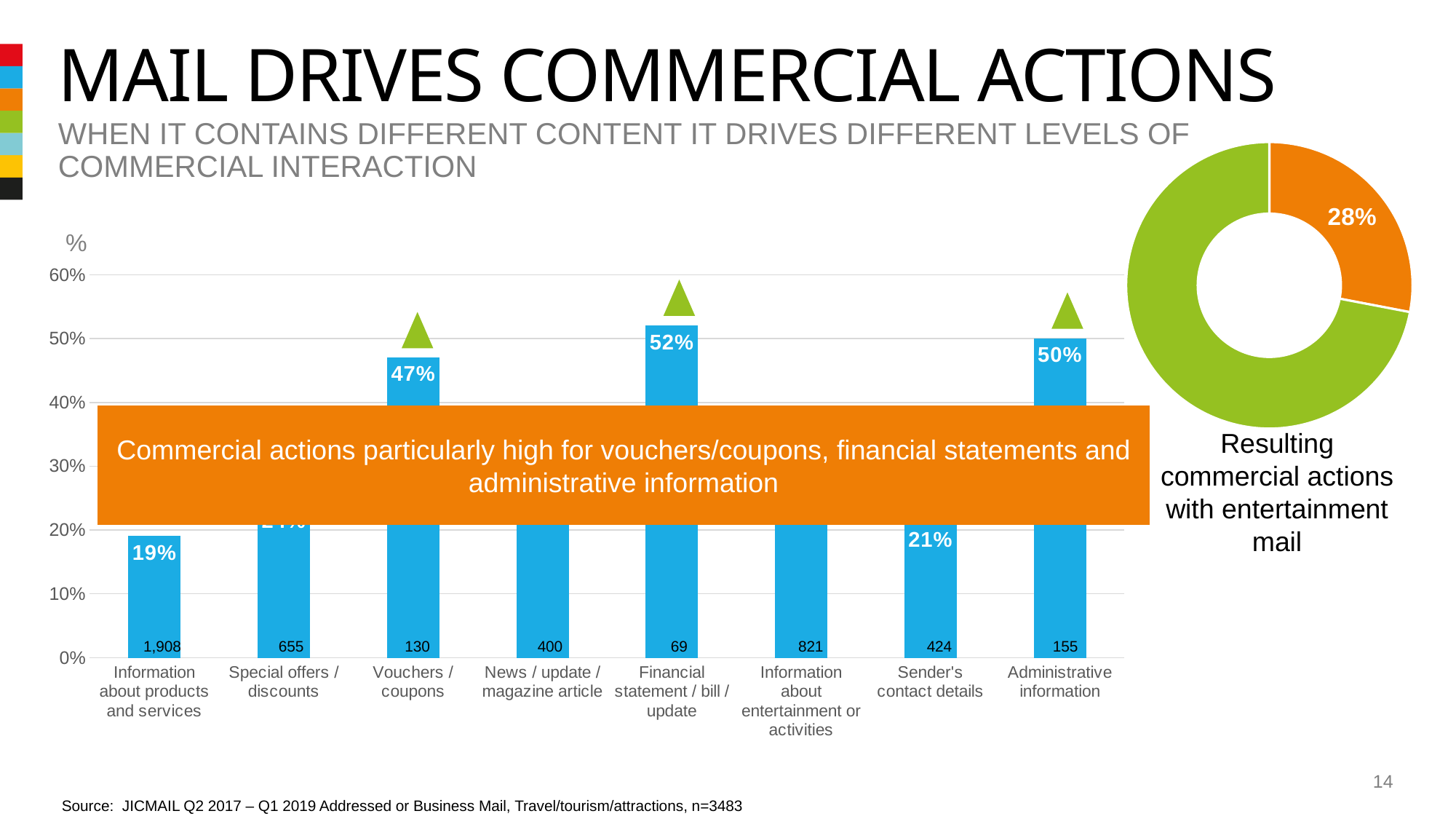
In the bar chart, what is the value for Administrative information? 50% In the bar chart, which category has the highest value? Financial statement / bill / update In the bar chart, which category has the lowest value? Information about products and services What type of chart is the chart on the right of the slide? Donut chart In the bar chart, what is the value for Information about products and services? 19% In the bar chart, what is the value for Vouchers / coupons? 47% In the donut chart on the right, what percentage is shown for the orange slice? 28% In the bar chart, is the value for Vouchers / coupons greater or less than 40%? greater In the bar chart, what is the value for Financial statement / bill / update? 52% How many categories are shown in the bar chart? 8 In the bar chart, what is the difference between the values for Financial statement / bill / update and Vouchers / coupons? 5% In the bar chart, what is the value for Sender's contact details? 21%